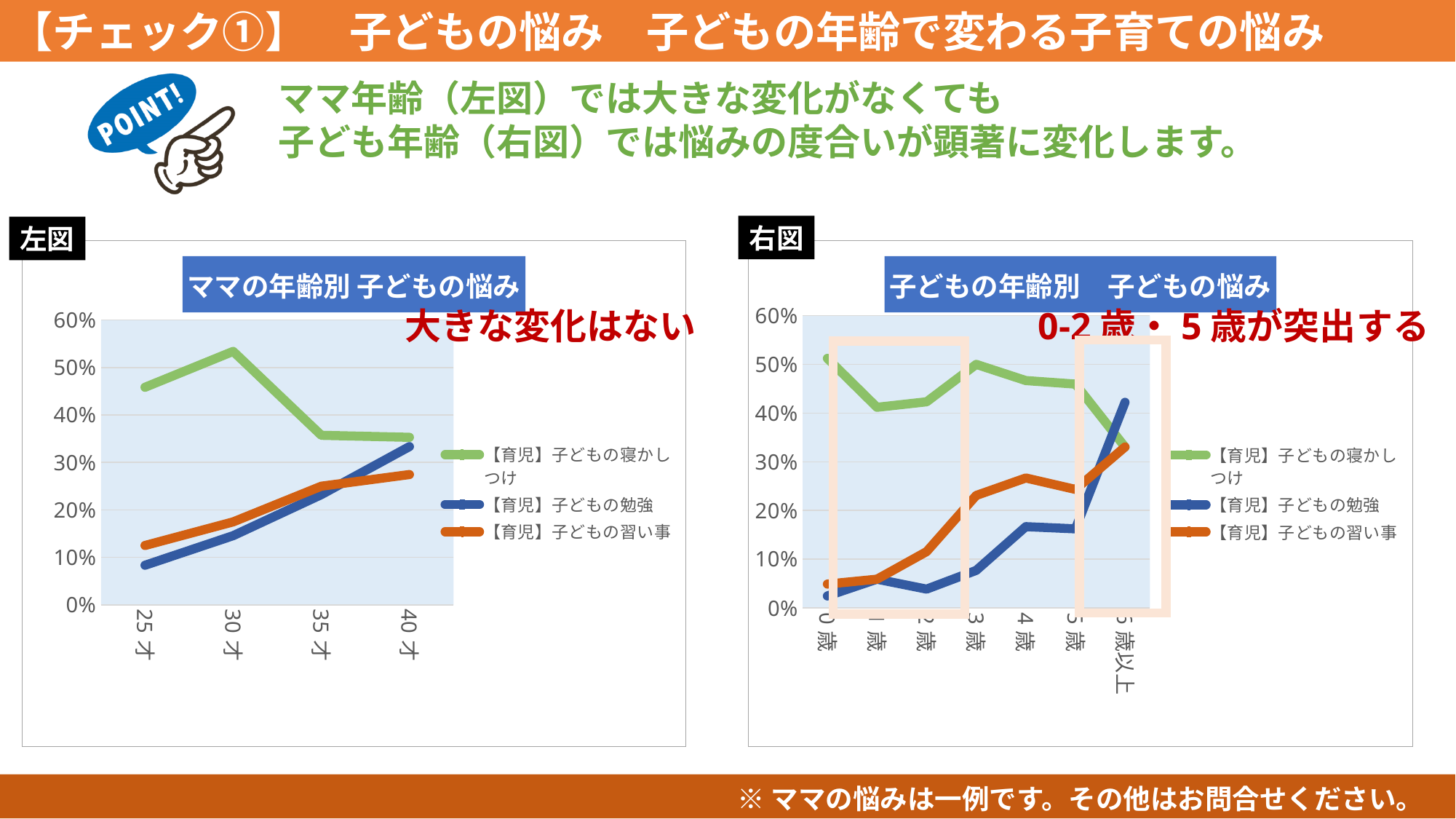
In the right chart (子どもの年齢別 子どもの悩み), at which age is 【育児】子どもの寝かしつけ lowest? 6歳以上 How many series does the legend of the right chart (子どもの年齢別 子どもの悩み) list? 3 In the left chart (ママの年齢別 子どもの悩み), is the value for 【育児】子どもの勉強 at 25才 greater or less than 10%? less What is the title of the right chart? 子どもの年齢別 子どもの悩み What kind of chart is the left chart (ママの年齢別 子どもの悩み)? line chart In the left chart (ママの年齢別 子どもの悩み), does the value for 【育児】子どもの勉強 rise or fall from 25才 to 40才? rise In the left chart (ママの年齢別 子どもの悩み), at which age is 【育児】子どもの寝かしつけ highest? 30才 In the left chart (ママの年齢別 子どもの悩み), is the value for 【育児】子どもの寝かしつけ at 30才 greater or less than 50%? greater How many categories are on the x axis of the left chart (ママの年齢別 子どもの悩み)? 4 How many categories are on the x axis of the right chart (子どもの年齢別 子どもの悩み)? 7 In the right chart (子どもの年齢別 子どもの悩み), at which age is 【育児】子どもの勉強 highest? 6歳以上